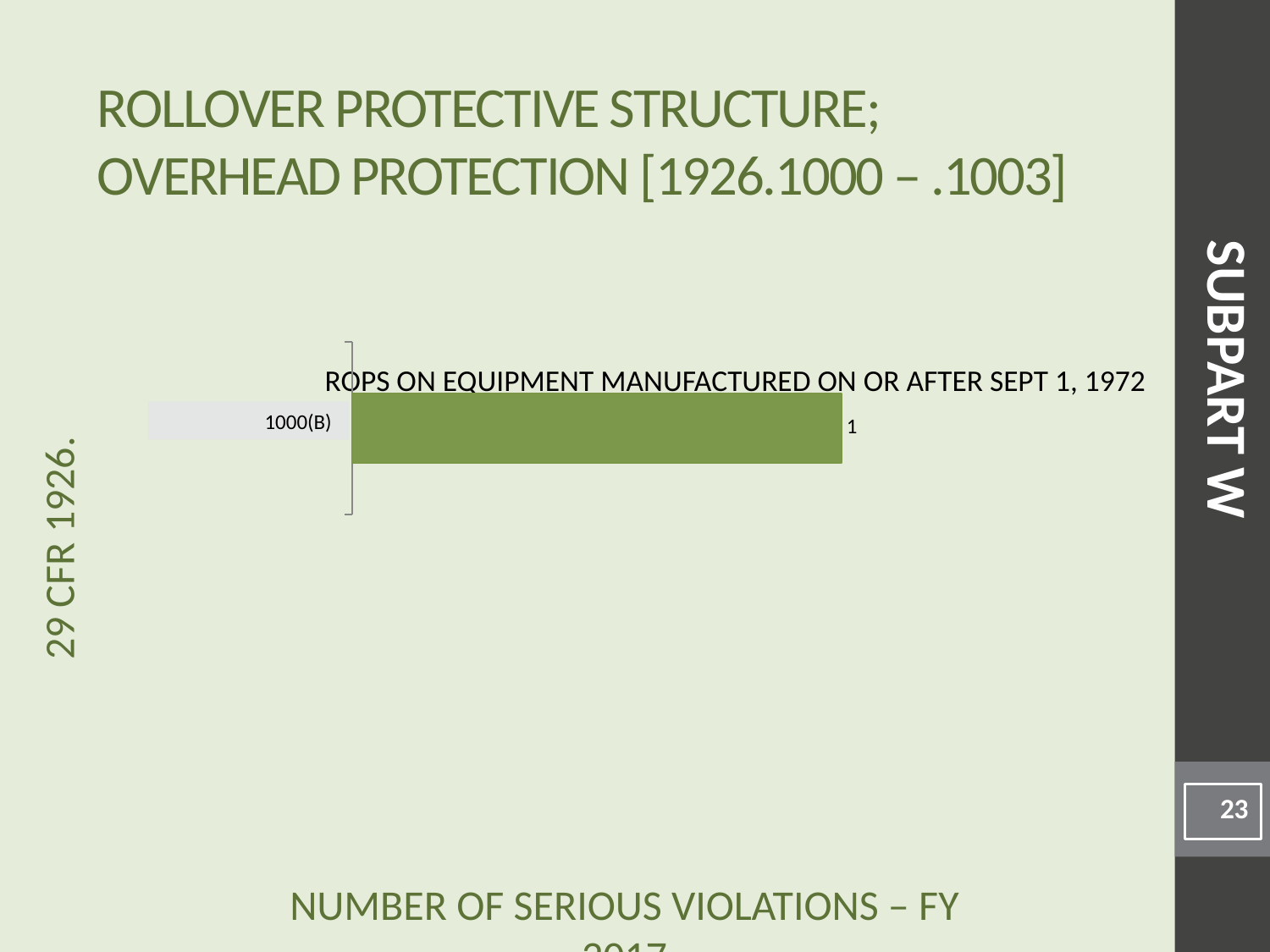
Is the value for 1000(B) greater or less than 0? greater What is the category label shown on the chart's axis? 1000(B) How many categories are plotted in the chart? 1 What text appears above the bar in the chart? ROPS ON EQUIPMENT MANUFACTURED ON OR AFTER SEPT 1, 1972 What is the number of serious violations for 1000(B)? 1 What kind of chart is shown on the slide? bar chart